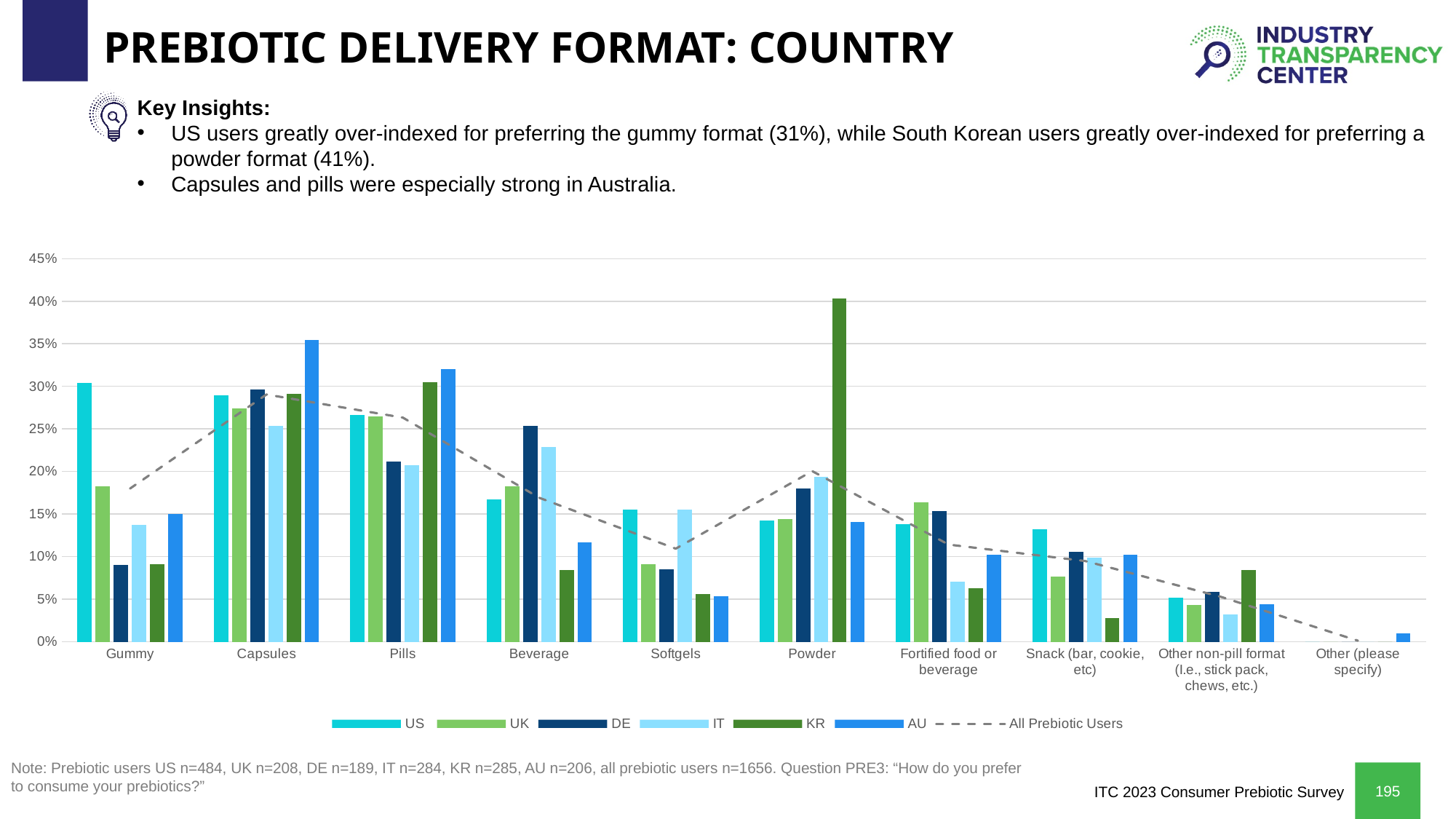
Is the DE value for Gummy greater or less than 10%? less Is the AU value for Capsules greater or less than 30%? greater Which is larger for Beverage, the DE value or the IT value? DE Which country has the highest bar for Gummy? US What kind of chart is shown on the slide? Bar chart (with a dashed line series) How many series does the legend list? 7 Does the All Prebiotic Users dashed line rise or fall from Capsules to Softgels? fall Which country has the lowest bar for Beverage? KR Is the KR value for Powder greater or less than 35%? greater Which country has the highest bar for Capsules? AU Which country has the highest bar for Powder? KR How many delivery format categories are shown on the x axis? 10